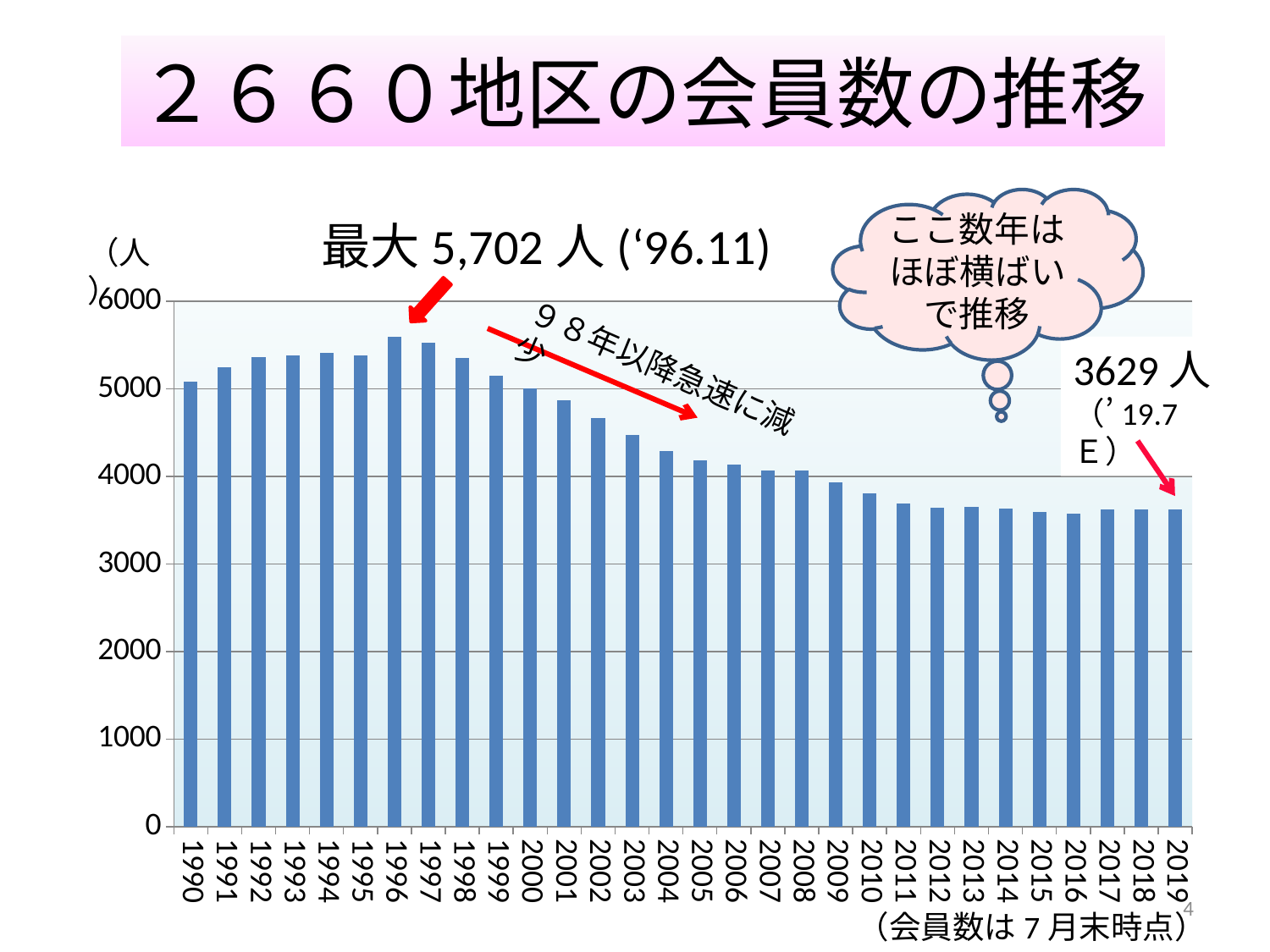
Is the value for 2002 greater or less than 5000? less What maximum membership value is annotated on the chart? 5,702 人 What kind of chart is shown on the slide? bar chart Which year has the highest bar in the chart? 1996 What is the title of the chart on the slide? ２６６０地区の会員数の推移 How many years (bars) are plotted in the chart? 30 Which year has the larger value, 1992 or 2002? 1992 Is the value for 1994 greater or less than 5000? greater Do the values rise or fall from 1998 to 2019? fall Is the value for 2005 greater or less than 4000? greater What is the membership value annotated for 2019 on the chart? 3629 人